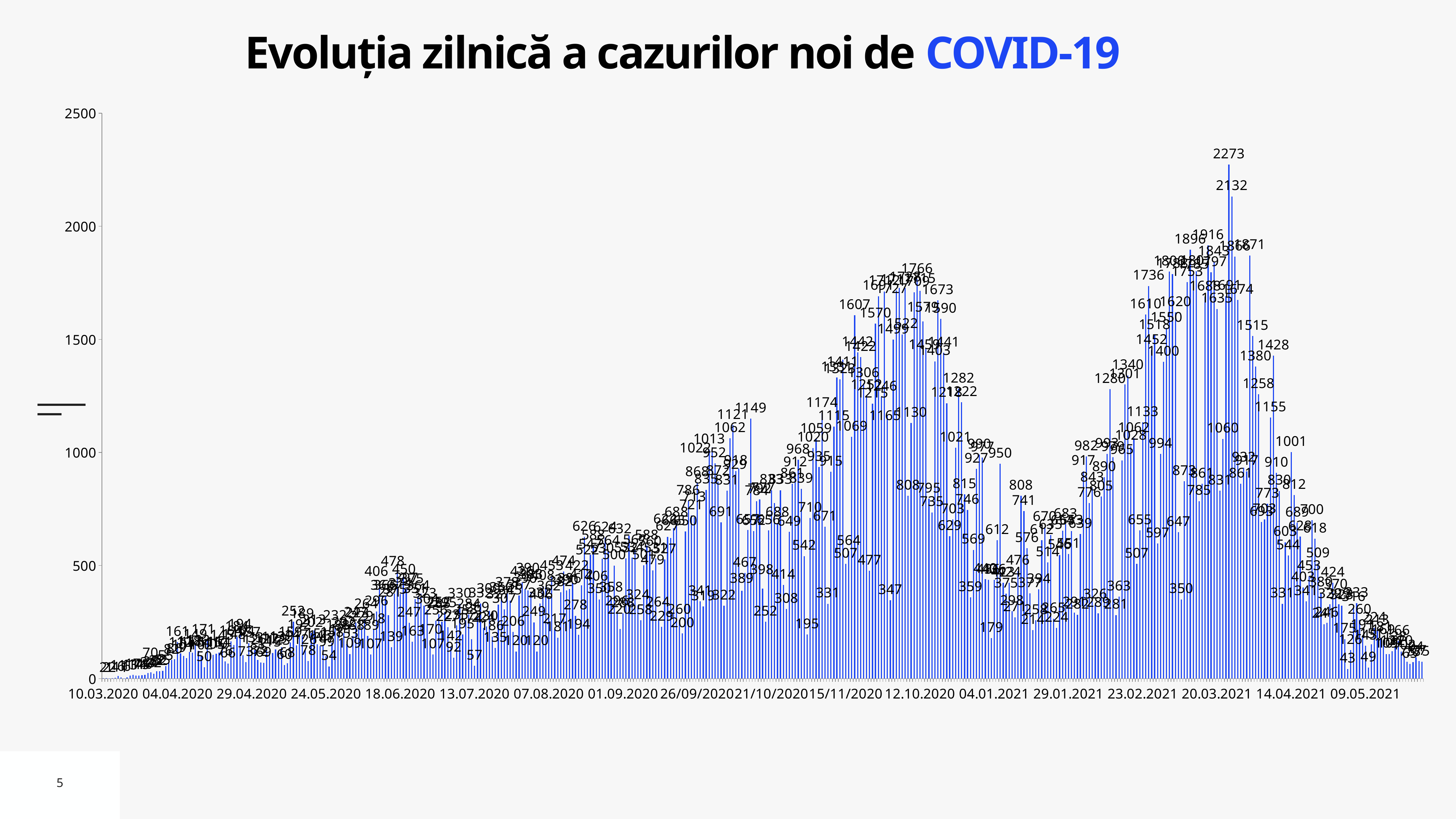
What is the maximum value shown on the vertical axis? 2500 Is the peak value around 15/11/2020 greater or less than 2000? less What is the difference between the two highest labelled values, 2273 and 2132? 141 What is the highest daily value labelled on the chart? 2273 What kind of chart is shown on the slide? bar chart What is the title of the chart? Evoluția zilnică a cazurilor noi de COVID-19 What is the second-highest value labelled on the chart, next to the 2273 peak? 2132 Is the peak value around 20.03.2021 greater or less than 2000? greater Is the highest value on the chart greater or less than 2000? greater Do the values rise or fall between 14.04.2021 and 09.05.2021? fall Do the values rise or fall between 10.03.2020 and 04.04.2020? rise Which is larger: the peak labelled 2273 or the peak labelled 1766? 2273